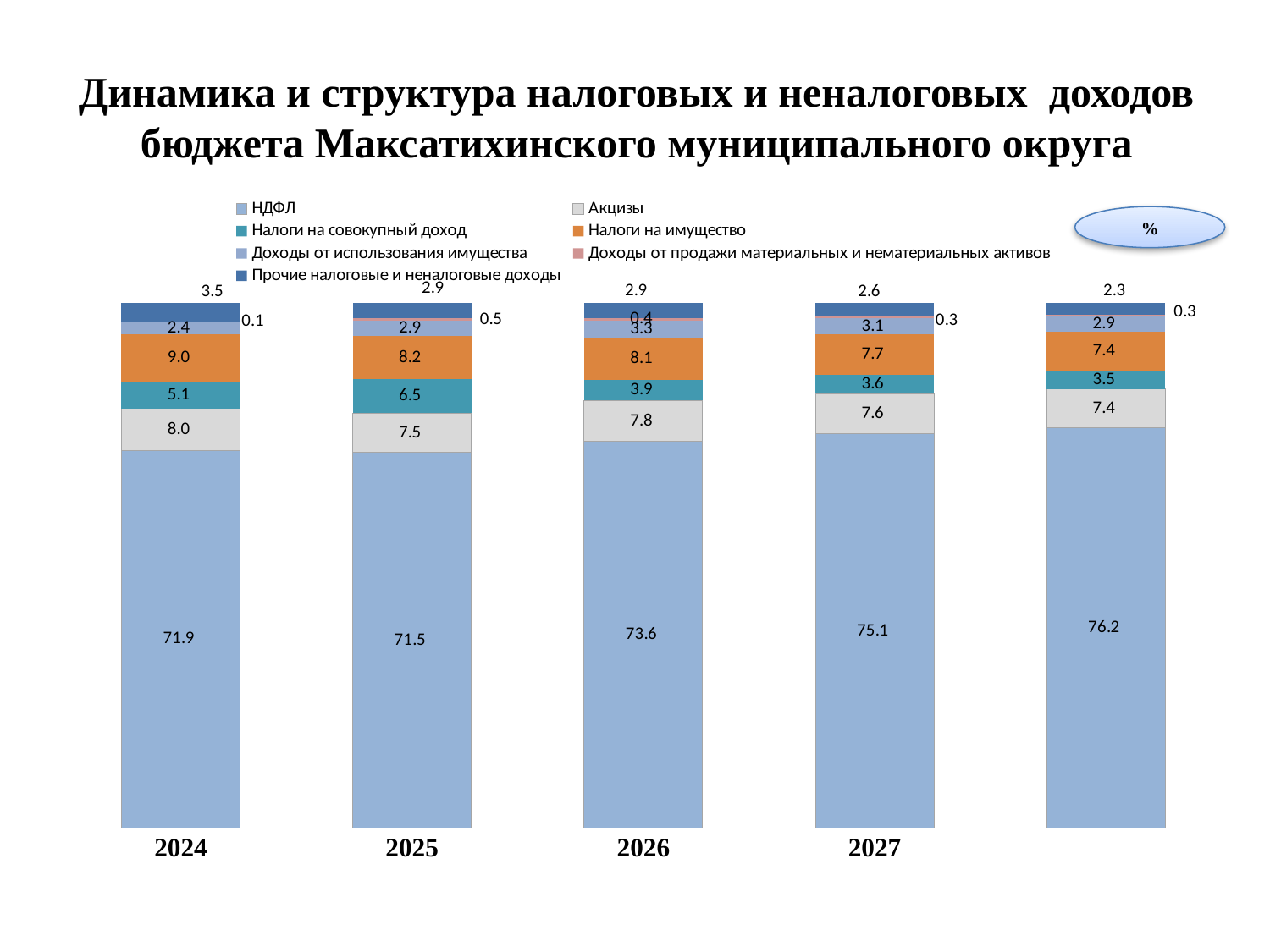
What is the value of Акцизы for 2027? 7.6 Among the years 2024 to 2027, which year has the lowest value for Налоги на совокупный доход? 2027 What is the value of Налоги на имущество for 2026? 8.1 Do the values for Прочие налоговые и неналоговые доходы rise or fall from 2024 to 2027? Fall Which is larger, Налоги на имущество in 2024 or in 2025? 2024 Among the years 2024 to 2027, which year has the highest value for НДФЛ? 2027 How many series does the legend list? 7 What is the difference between the НДФЛ values for 2027 and 2024? 3.2 What kind of chart is shown on the slide? Stacked bar chart What is the value of Налоги на совокупный доход for 2025? 6.5 What is the total of the stacked bar for 2024? 100.0 What is the value of НДФЛ for 2024? 71.9